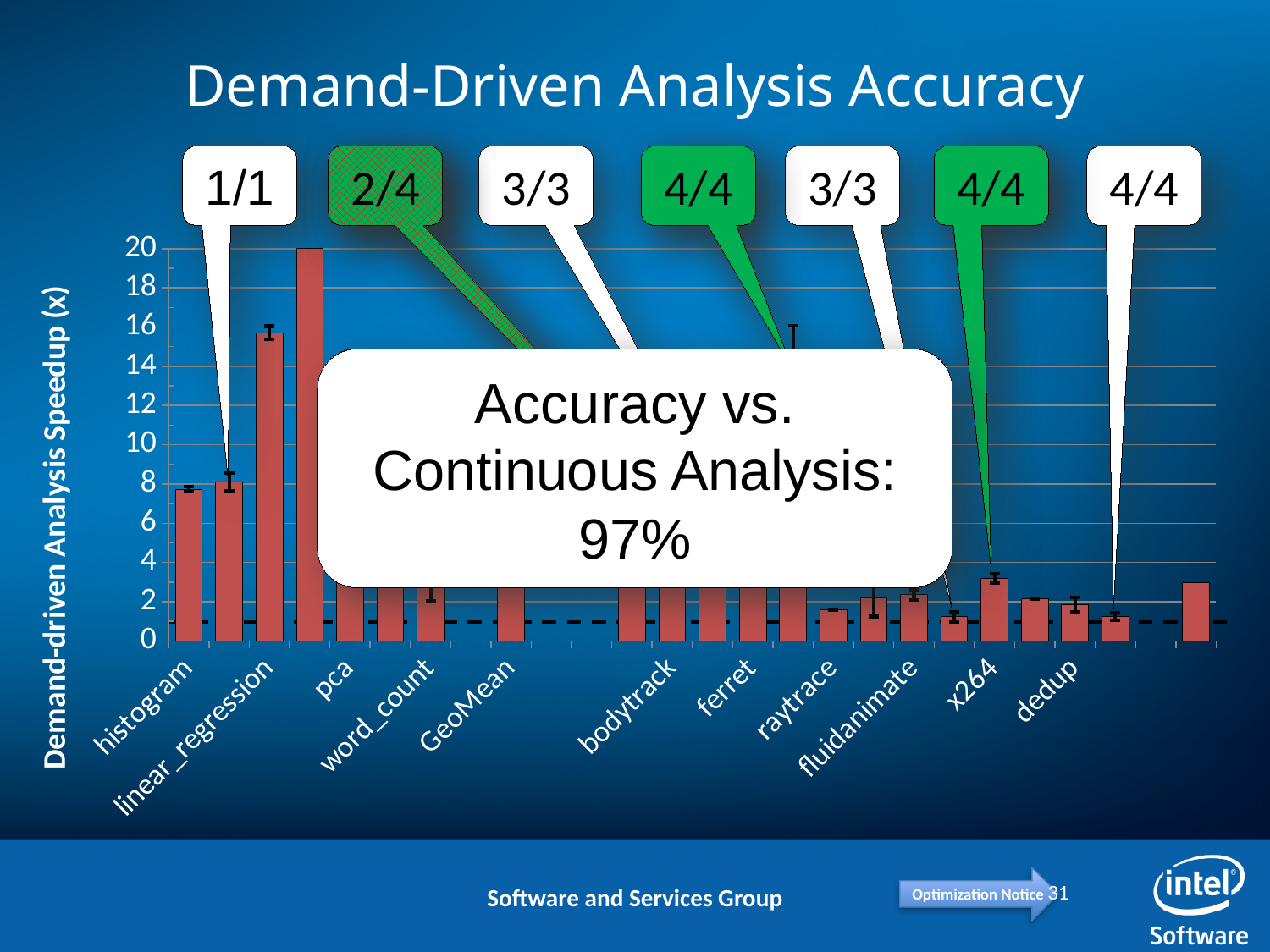
What is the title of the chart on the slide? Demand-Driven Analysis Accuracy What is the label of the y axis of the chart? Demand-driven Analysis Speedup (x) Is the value for histogram greater or less than 10? less Is the value for histogram greater or less than 6? greater What is the highest tick value shown on the y axis of the chart? 20 What kind of chart is shown on the slide? bar chart